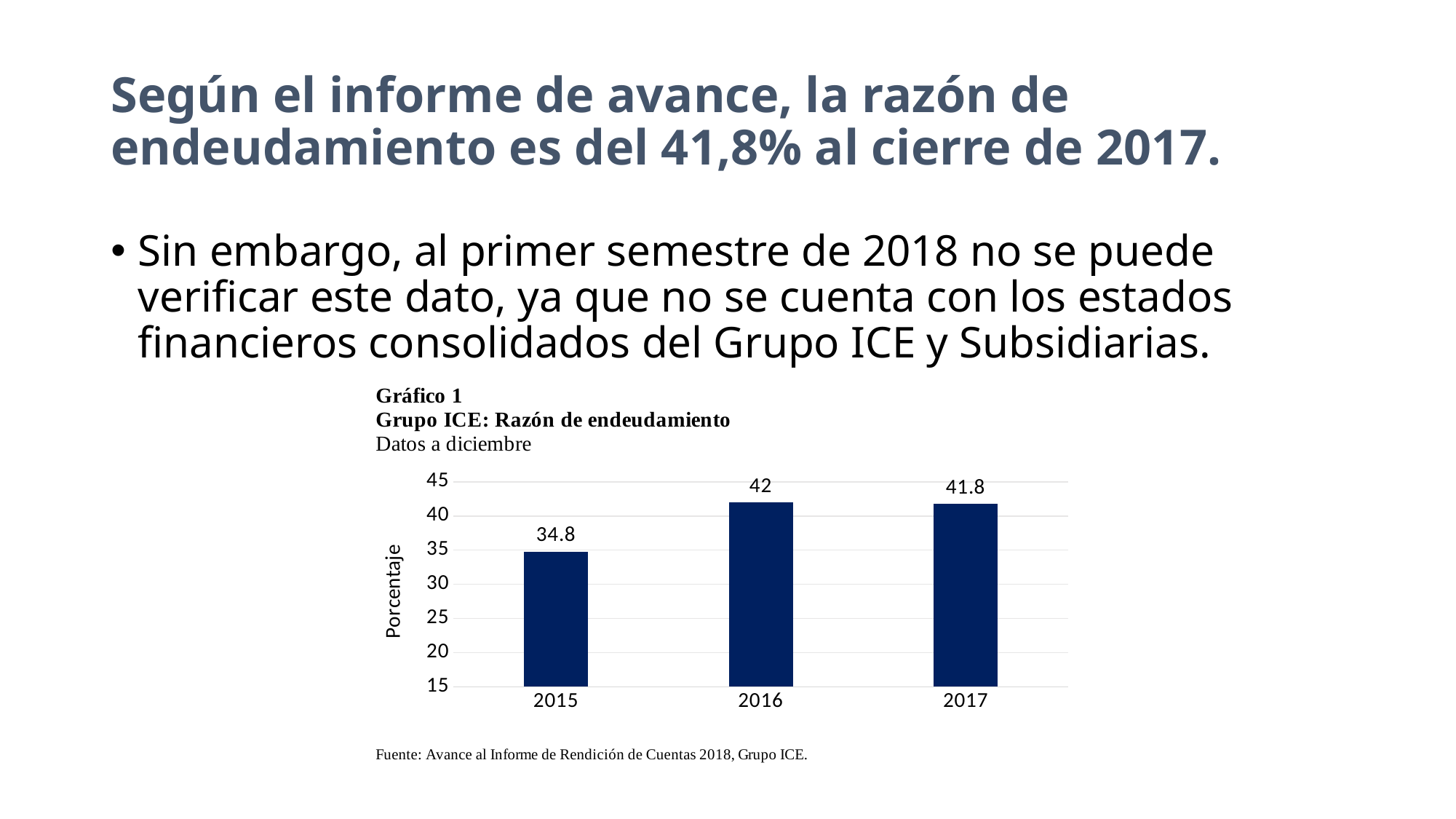
What is the value for 2017? 41.8 Is the value for 2015 greater or less than 35? less What is the value for 2015? 34.8 What is the label of the y axis? Porcentaje What kind of chart is shown? bar chart How many years are shown on the x axis? 3 What is the difference between the values for 2016 and 2015? 7.2 What is the difference between the values for 2016 and 2017? 0.2 Which is larger, the value for 2015 or the value for 2017? 2017 What is the value for 2016? 42 Which year has the lowest value? 2015 Which year has the highest value? 2016